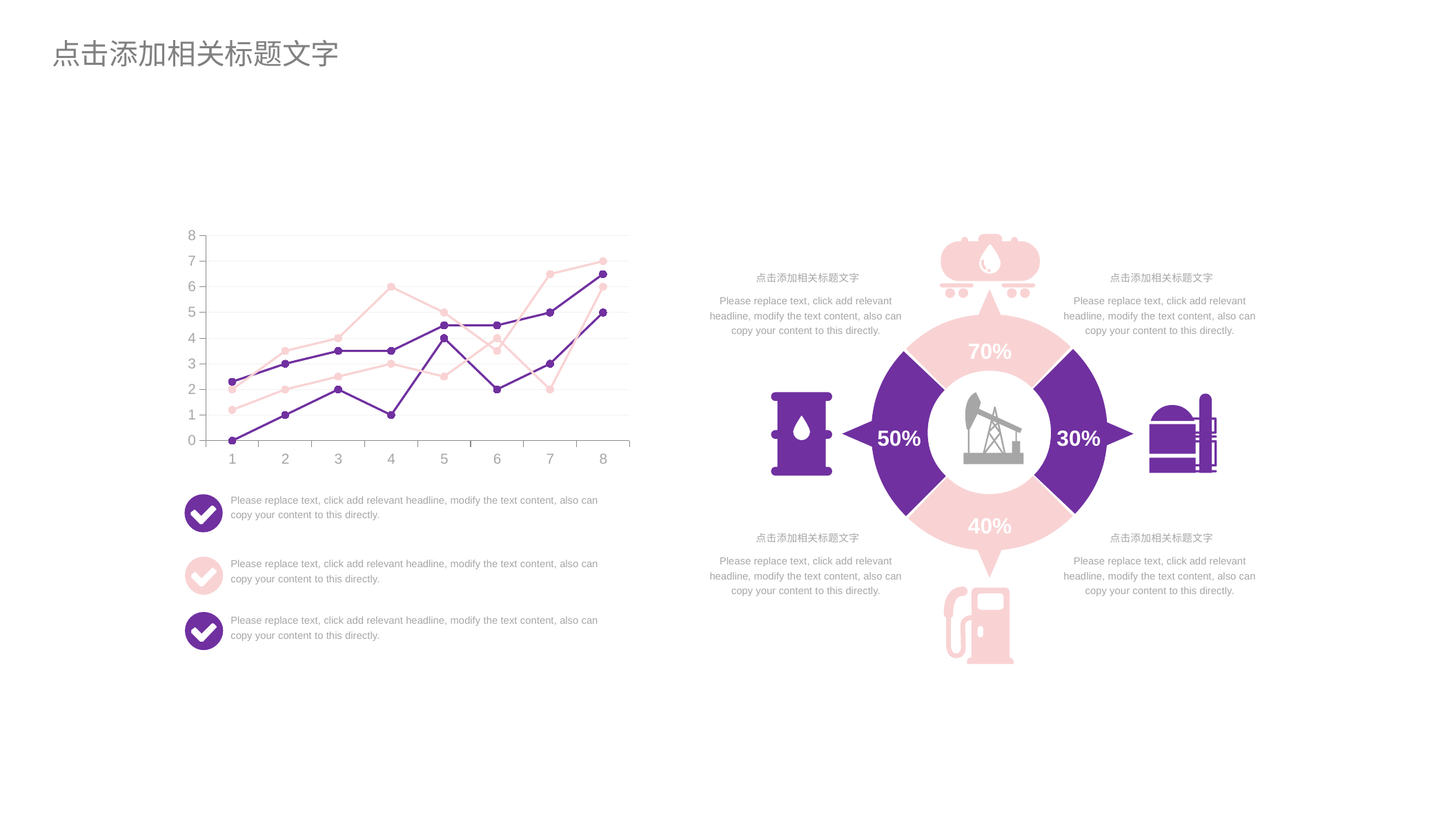
In the circular diagram on the right, which segment shows the smallest percentage? the right segment (30%) In the circular diagram on the right, what percentage is shown in the top segment? 70% In the line chart, at x = 8, what is the value of the highest line? 7 In the line chart, does the dark purple line that starts at 0 generally rise or fall from x = 1 to x = 8? rise In the line chart, is the value of the dark purple line that starts at 0 greater or less than 3 at x = 5? greater What is the lowest value reached by any line in the line chart? 0 How many lines are plotted in the line chart? 4 What kind of chart is shown on the left of the slide? line chart What is the highest value reached by any line in the line chart? 7 How many points are marked along the x axis of the line chart? 8 What is the highest value shown on the y axis of the line chart? 8 In the line chart, at x = 1, what is the value of the lowest line? 0